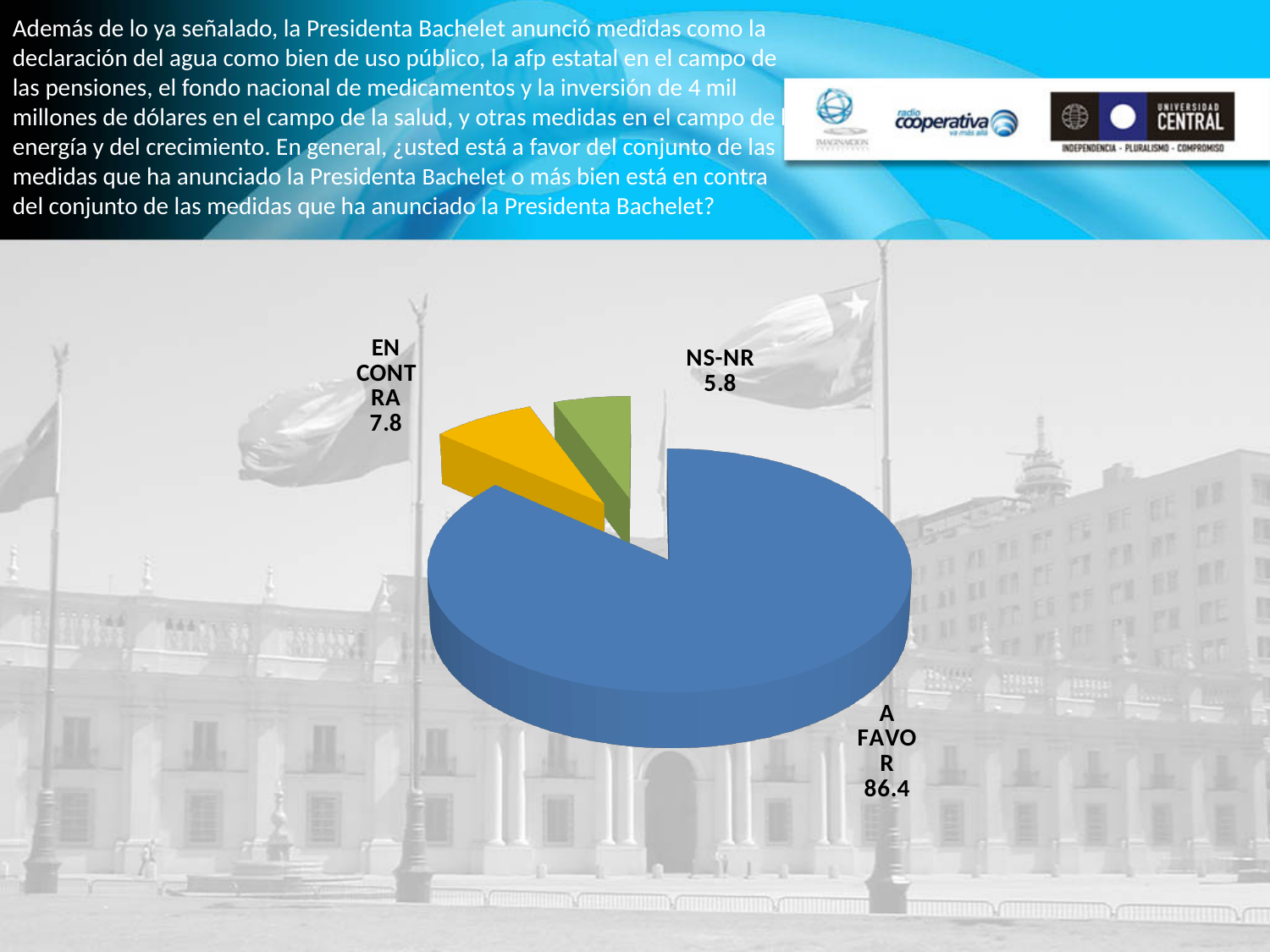
Which is larger, EN CONTRA or NS-NR? EN CONTRA What colour is the EN CONTRA slice? yellow What is the value for EN CONTRA? 7.8 How many slices does the pie chart have? 3 What kind of chart is shown on the slide? pie chart Which category has the smallest slice? NS-NR What is the value for NS-NR? 5.8 What is the value for A FAVOR? 86.4 Which category has the largest slice? A FAVOR What is the difference between the values for A FAVOR and EN CONTRA? 78.6 What colour is the A FAVOR slice? blue What is the difference between the values for EN CONTRA and NS-NR? 2.0